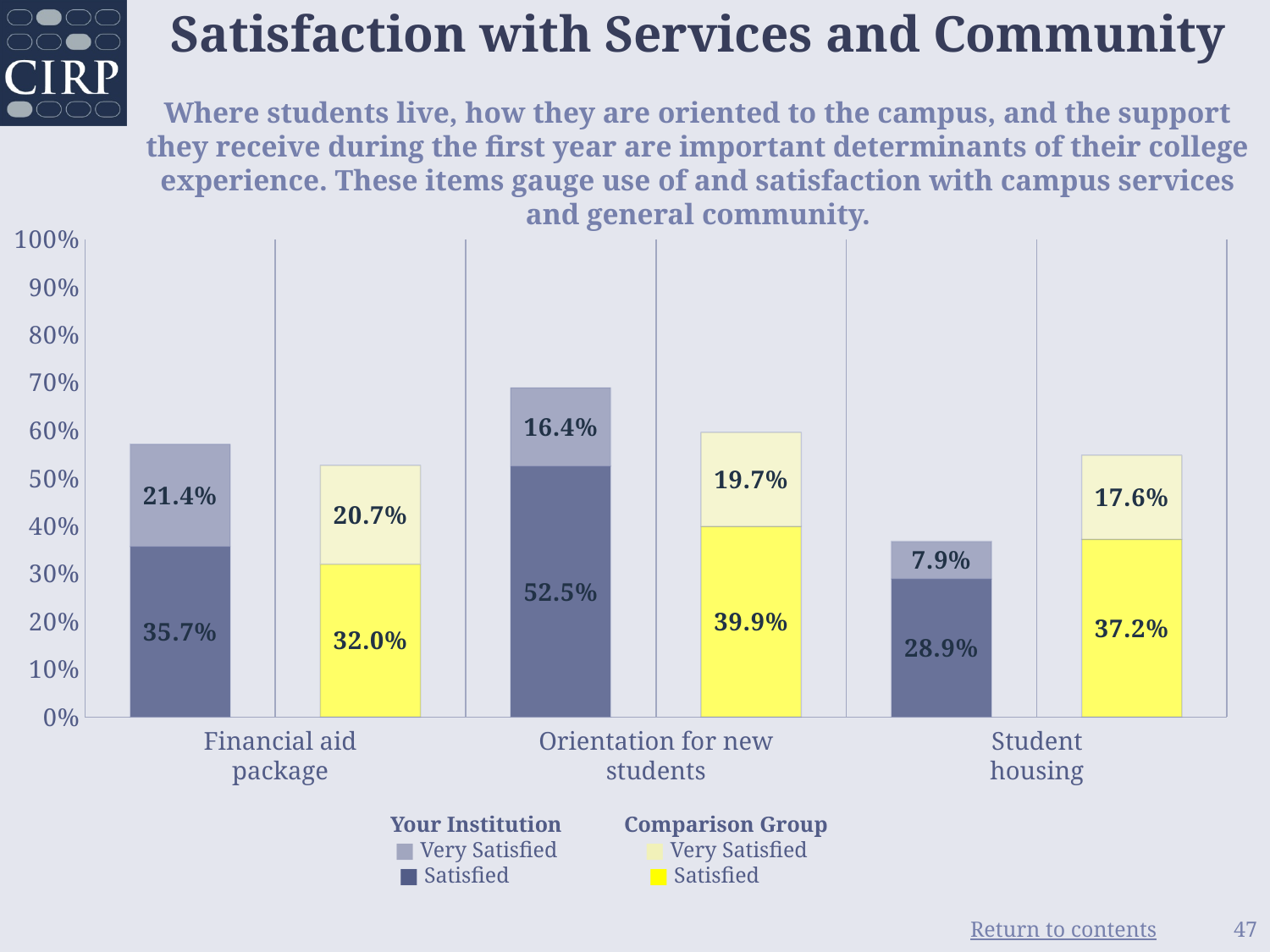
How many series does the legend list? 4 What is the total of the stacked bar for the Comparison Group for Student housing? 54.8% Which category has the highest Satisfied percentage for Your Institution? Orientation for new students How many categories are shown on the x axis? 3 What is the total of the stacked bar for Your Institution for Orientation for new students? 68.9% What percentage of the Comparison Group were Very Satisfied with Orientation for new students? 19.7% What kind of chart is shown on the slide? Stacked bar chart For Orientation for new students, which is larger: Your Institution's Satisfied percentage or the Comparison Group's Satisfied percentage? Your Institution What percentage of students at Your Institution were Satisfied with the Financial aid package? 35.7% What is the difference between the Comparison Group's Satisfied percentage and Your Institution's Satisfied percentage for Student housing? 8.3% Which category has the lowest Very Satisfied percentage for Your Institution? Student housing What percentage of students at Your Institution were Very Satisfied with Student housing? 7.9%